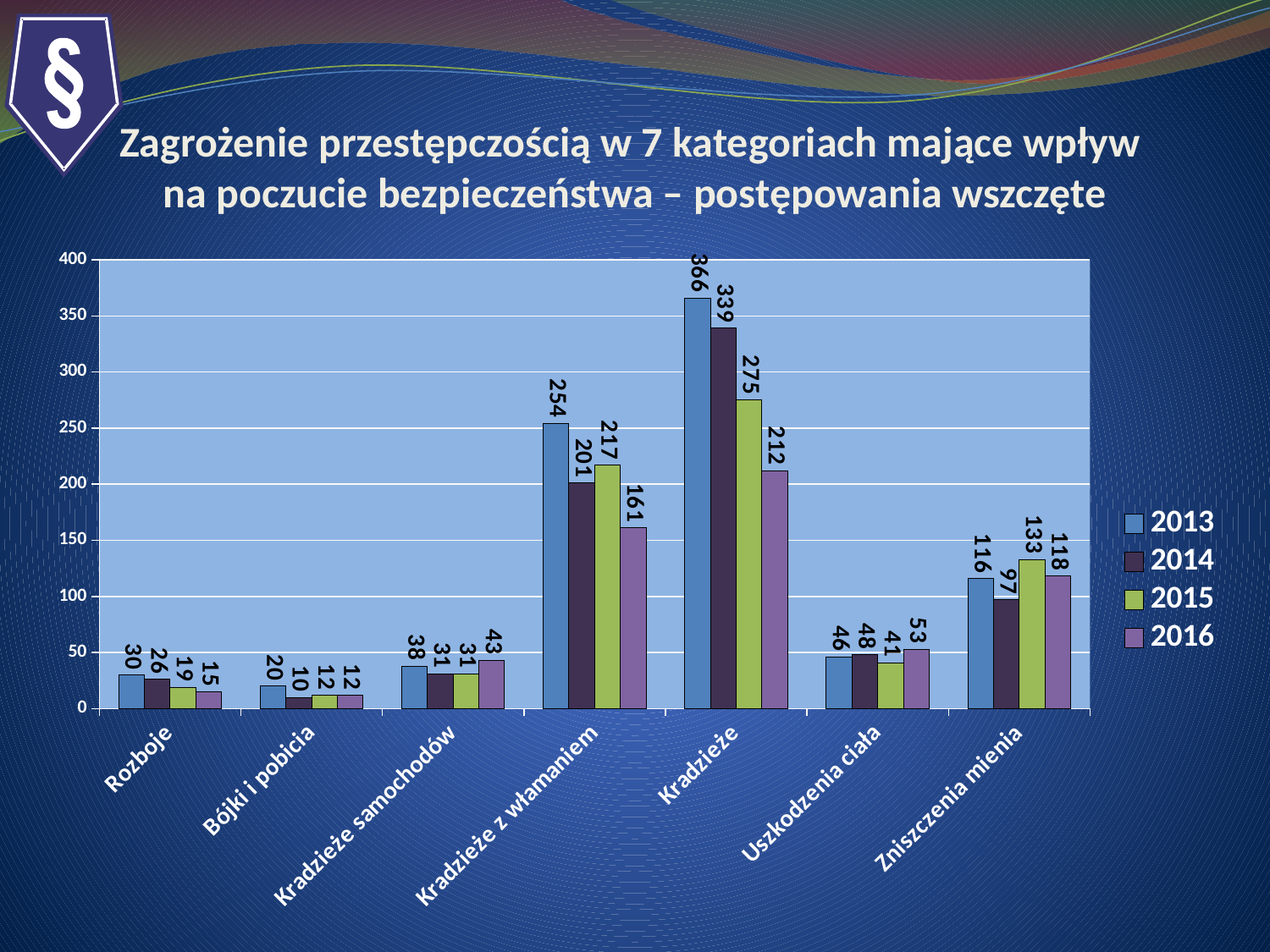
Which is larger for Uszkodzenia ciała: the 2014 value or the 2016 value? 2016 Do the values for Kradzieże rise or fall from 2013 to 2016? fall What is the difference between the 2013 and 2016 values for Kradzieże? 154 What kind of chart is shown on the slide? bar chart Which category has the lowest value in 2014? Bójki i pobicia How many series does the legend list? 4 How many categories are shown on the x axis? 7 What is the value for Kradzieże in 2013? 366 What is the value for Kradzieże z włamaniem in 2016? 161 Is the value for Kradzieże z włamaniem in 2015 greater or less than 200? greater Which category has the highest value in 2014? Kradzieże What is the value for Zniszczenia mienia in 2015? 133